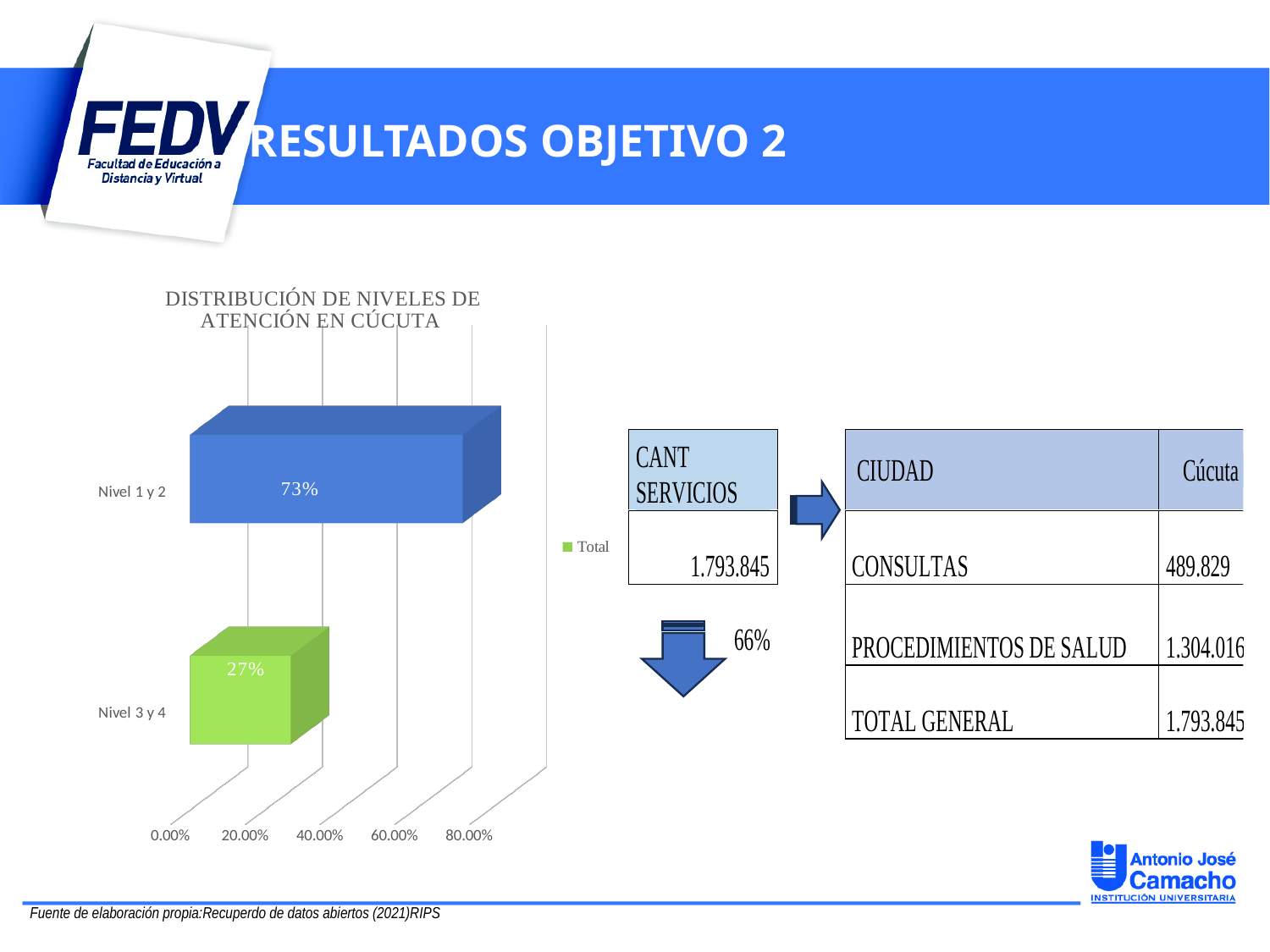
What is the value for Nivel 3 y 4 in the chart? 27% How many series does the chart legend list? 1 Is the value for Nivel 1 y 2 greater or less than 60.00%? greater Which is larger, the value for Nivel 1 y 2 or the value for Nivel 3 y 4? Nivel 1 y 2 What kind of chart is shown on the slide? bar chart What is the difference between the values for Nivel 1 y 2 and Nivel 3 y 4? 46% What is the value for Nivel 1 y 2 in the chart? 73% Is the value for Nivel 3 y 4 greater or less than 40.00%? less How many categories are shown in the chart? 2 What is the title of the chart? DISTRIBUCIÓN DE NIVELES DE ATENCIÓN EN CÚCUTA Which category has the lowest value in the chart? Nivel 3 y 4 Which category has the highest value in the chart? Nivel 1 y 2